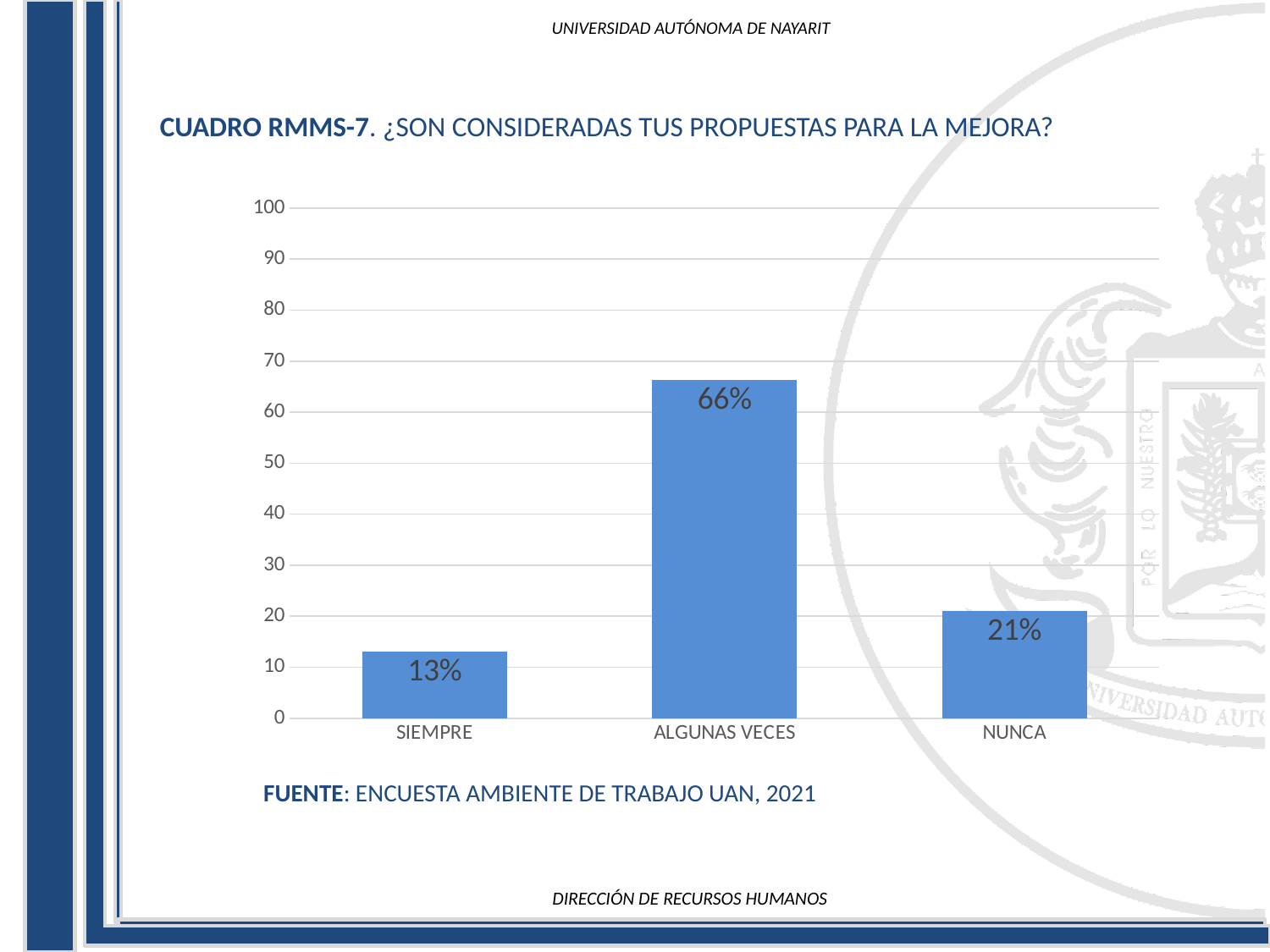
What is the difference between the values for NUNCA and SIEMPRE? 8% Which is larger, the value for NUNCA or the value for SIEMPRE? NUNCA Which category has the highest value? ALGUNAS VECES What is the difference between the values for ALGUNAS VECES and NUNCA? 45% What is the value for SIEMPRE? 13% What is the value for NUNCA? 21% Which category has the lowest value? SIEMPRE How many categories are shown on the x axis? 3 What is the source cited below the chart? ENCUESTA AMBIENTE DE TRABAJO UAN, 2021 Is the value for ALGUNAS VECES greater or less than 60? greater What kind of chart is shown on the slide? bar chart What is the value for ALGUNAS VECES? 66%